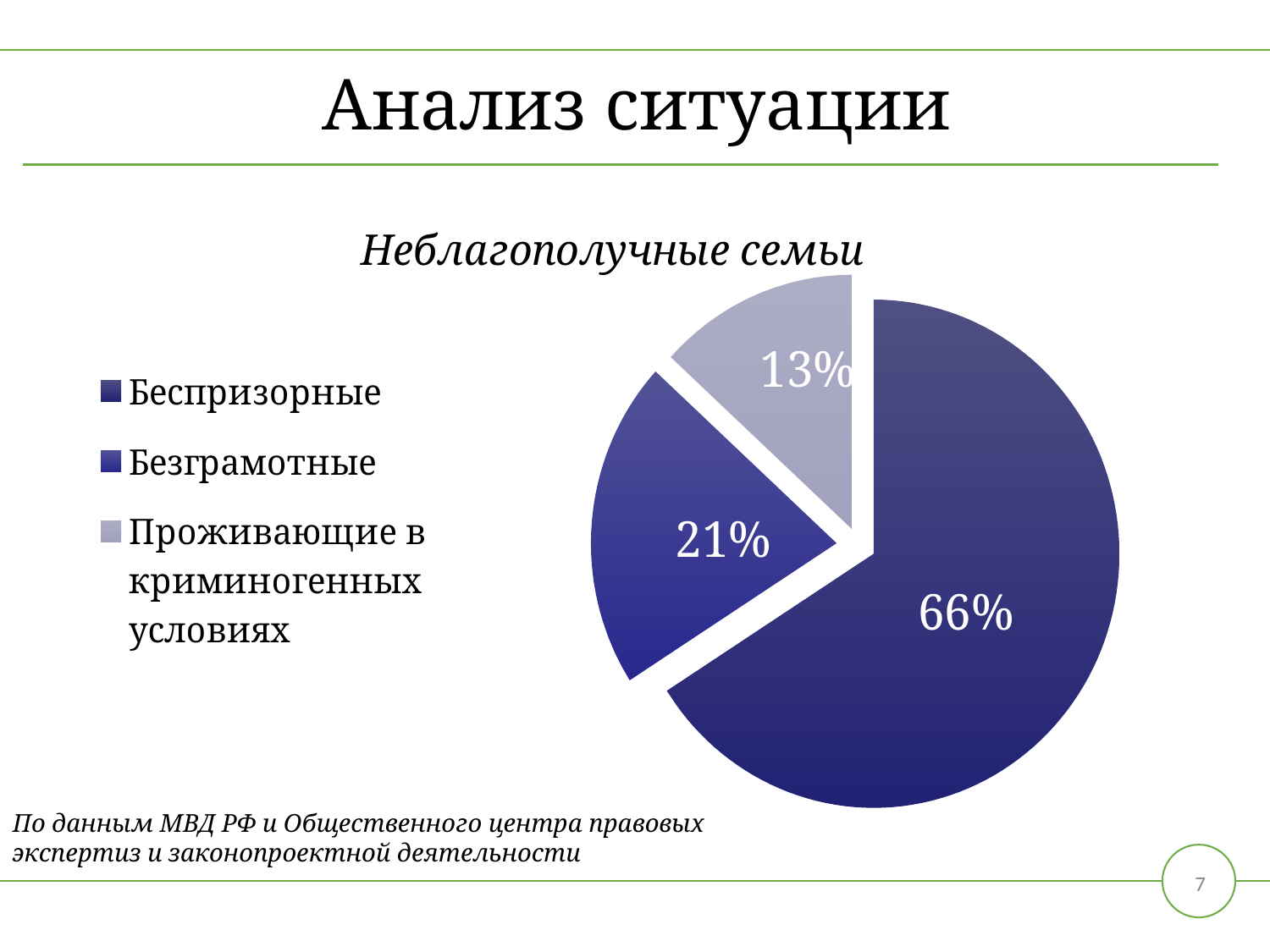
What kind of chart is shown on the slide? pie chart What share of the pie does Безграмотные take? 21% Which legend entry is shown in the lightest colour? Проживающие в криминогенных условиях Which category has the smallest slice of the pie? Проживающие в криминогенных условиях Which category has the largest slice of the pie? Беспризорные What share of the pie does Беспризорные take? 66% How many slices does the pie chart have? 3 How many entries does the legend list? 3 What share of the pie does Проживающие в криминогенных условиях take? 13% What is the title of the chart? Неблагополучные семьи What is the difference in percentage points between Беспризорные and Безграмотные? 45 Which is larger, the slice for Безграмотные or the slice for Проживающие в криминогенных условиях? Безграмотные